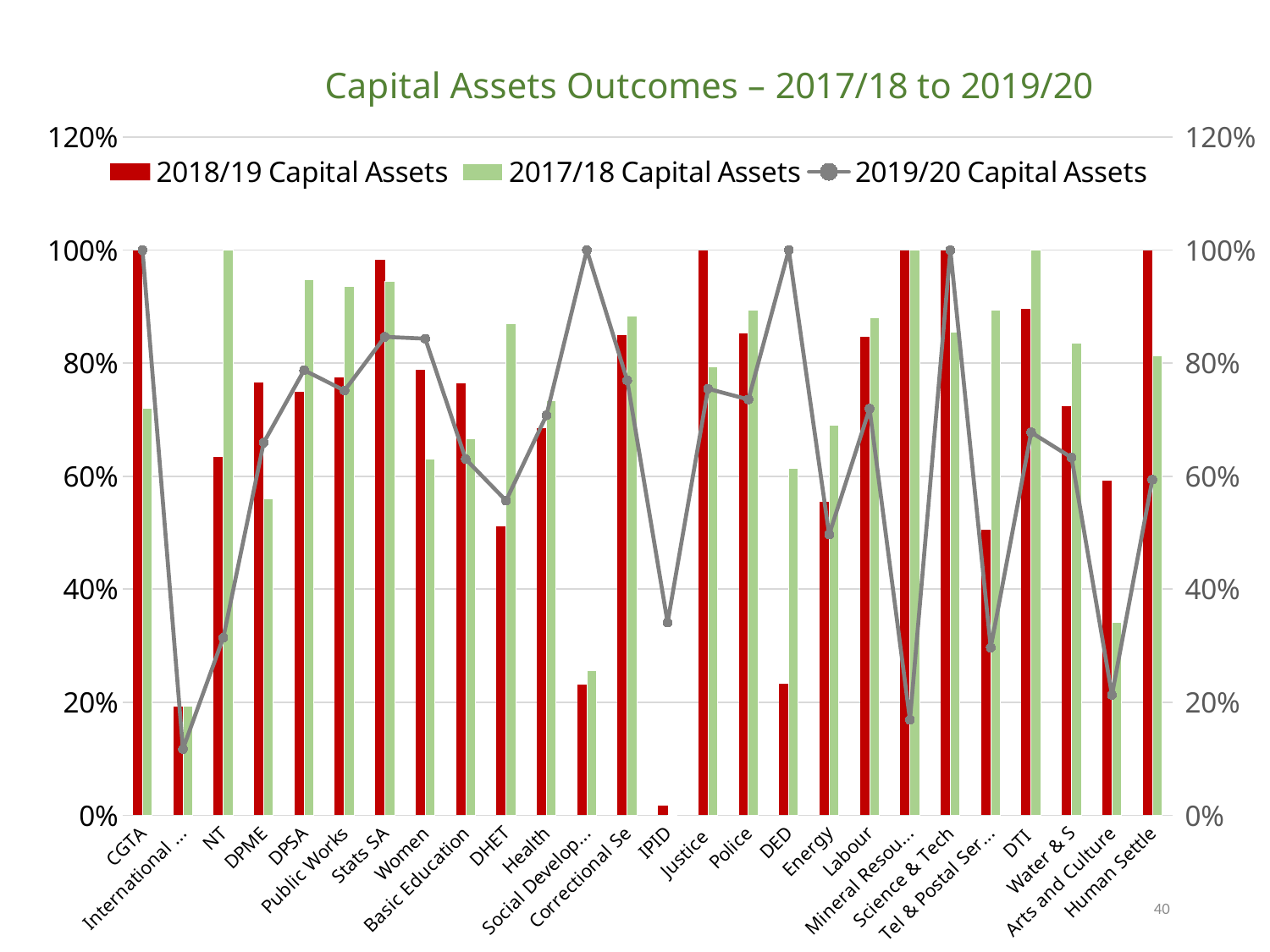
What is the 2018/19 Capital Assets value for CGTA? 100% What is the title of the chart? Capital Assets Outcomes – 2017/18 to 2019/20 For DPME, which is larger: the 2018/19 Capital Assets value or the 2017/18 Capital Assets value? 2018/19 Capital Assets What is the 2018/19 Capital Assets value for Justice? 100% Is the 2018/19 Capital Assets value for IPID greater or less than 20%? less Which category has the lowest 2018/19 Capital Assets value? IPID What is the 2019/20 Capital Assets value for DED? 100% Is the 2018/19 Capital Assets value for Stats SA greater or less than 80%? greater How many categories are shown on the x axis? 26 What is the 2017/18 Capital Assets value for DTI? 100% How many series does the legend list? 3 Is the 2017/18 Capital Assets value for Arts and Culture greater or less than 40%? less